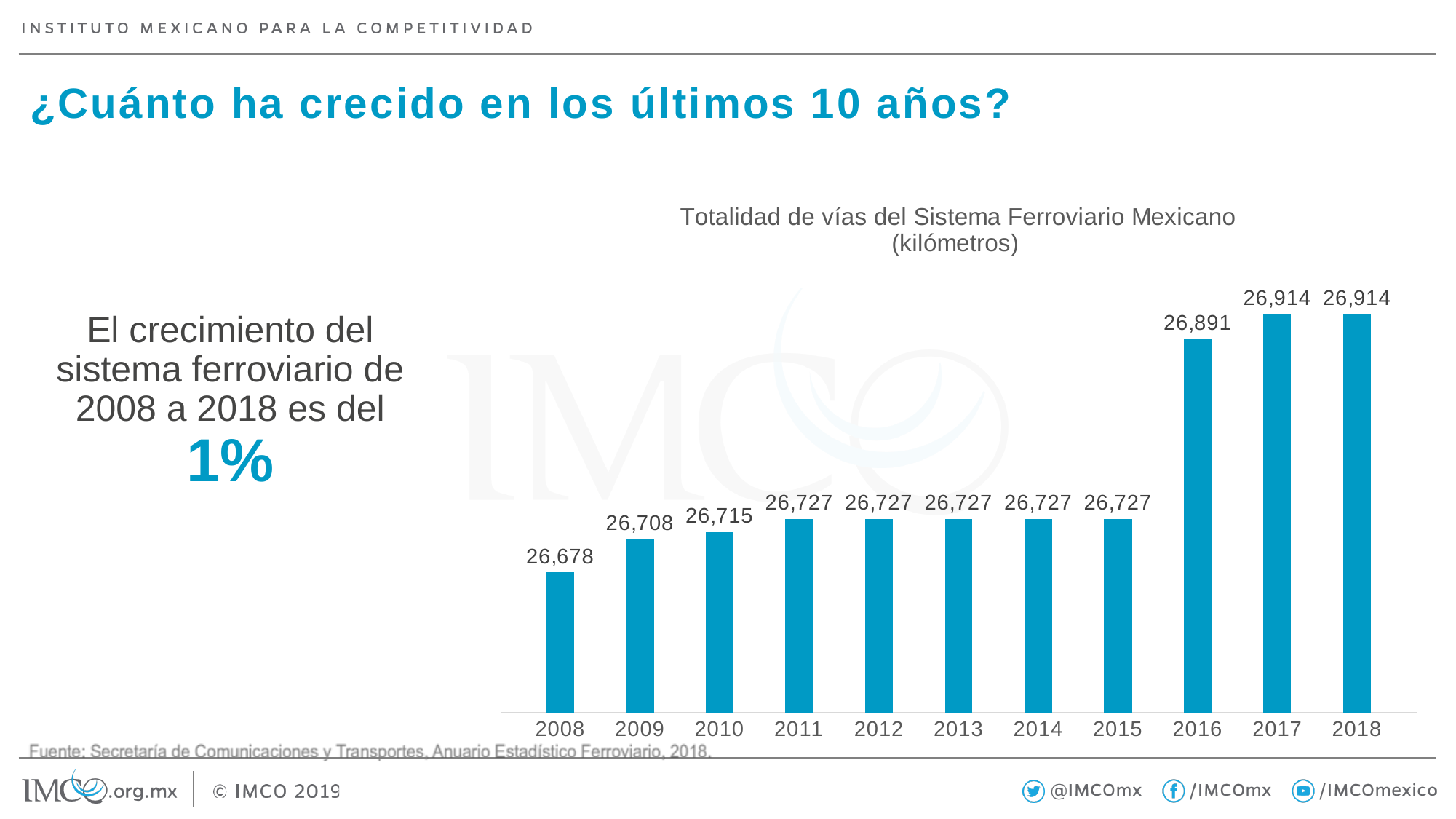
What is the value for 2016? 26,891 Which year has the lowest value? 2008 What kind of chart is this? Bar chart What is the value for 2008? 26,678 How many years share the value 26,727? 5 How many years are shown on the x axis? 11 What is the difference between the values for 2017 and 2016? 23 What is the difference between the values for 2018 and 2008? 236 Do the values rise or fall from 2008 to 2018? Rise What is the title of the chart? Totalidad de vías del Sistema Ferroviario Mexicano (kilómetros) Which is larger, the value for 2009 or the value for 2015? 2015 What is the value for 2010? 26,715